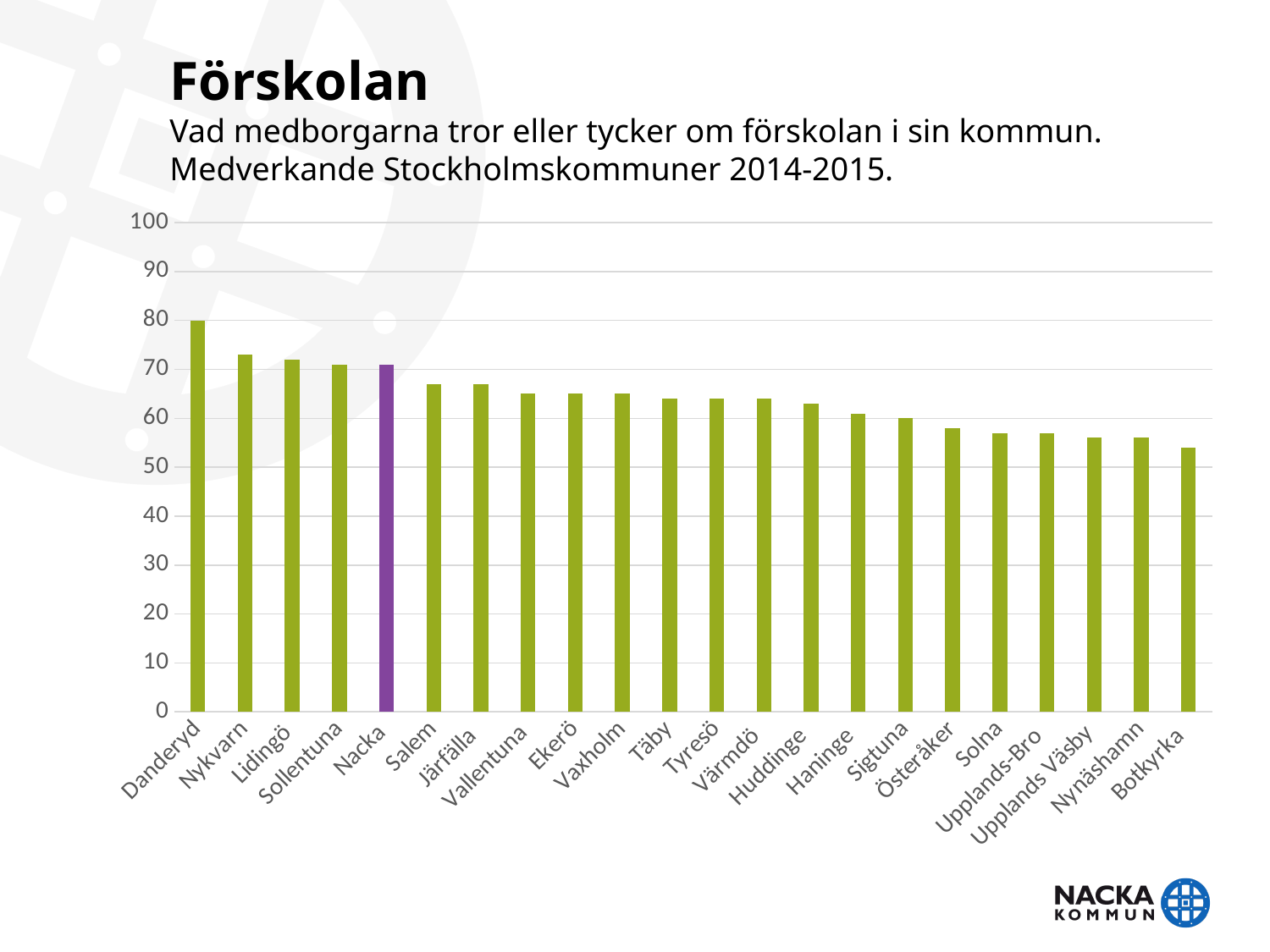
Do the values rise or fall from left to right along the x axis? Fall Which has a higher value, Nykvarn or Solna? Nykvarn How many municipalities are shown in the chart? 22 Which municipality's bar is highlighted in purple? Nacka Is the value for Salem greater or less than 60? greater Which has a higher value, Danderyd or Botkyrka? Danderyd Is the value for Nykvarn greater or less than 70? greater What kind of chart is shown on the slide? Bar chart Is the value for Botkyrka greater or less than 60? less Which municipality has the highest value in the chart? Danderyd Which municipality has the lowest value in the chart? Botkyrka